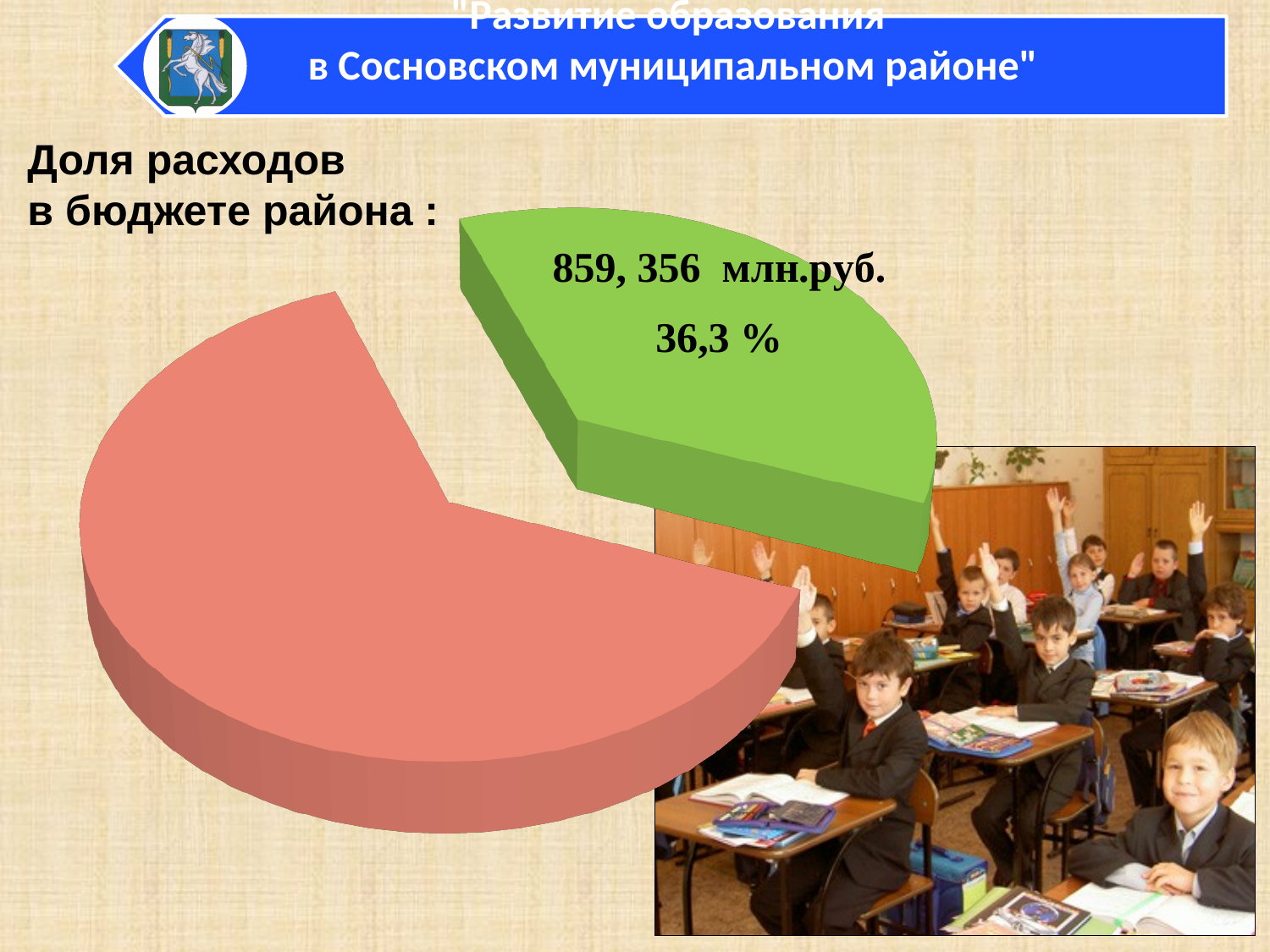
What amount in млн.руб. is printed on the green slice of the pie chart? 859, 356 млн.руб. What colour is the exploded (pulled-out) slice of the pie chart? green Which slice of the pie chart is larger, the green one or the red one? the red one Which slice of the pie chart is the largest? the red slice What is the heading text placed next to the pie chart? Доля расходов в бюджете района : Is the share of the green slice greater or less than 50%? less What percentage share is printed on the green slice of the pie chart? 36,3 % Which slice of the pie chart is the smallest? the green slice (36,3 %) What kind of chart is shown on the slide? pie chart How many slices does the pie chart have? 2